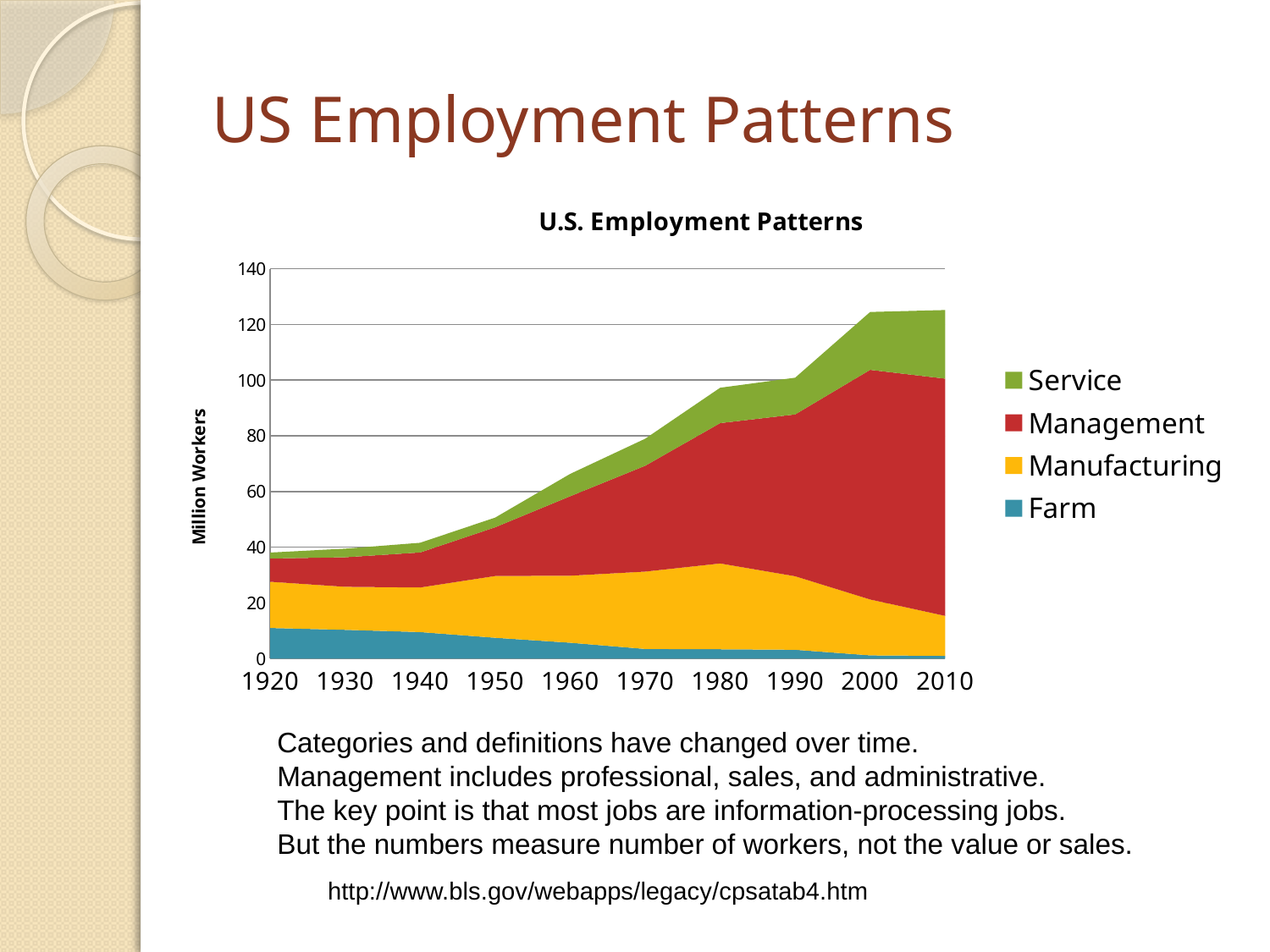
What is the title of the chart? U.S. Employment Patterns How many years are marked along the x axis? 10 How many series does the legend list? 4 Is the total number of workers in 1950 greater or less than 40? greater Is the total number of workers in 2010 greater or less than 120? greater Which is larger in 2010, the Management series or the Farm series? Management Does the total number of workers rise or fall from 1920 to 2010? Rise What is the label on the vertical axis? Million Workers What kind of chart is shown on the slide? Stacked area chart Is the total number of workers in 1960 greater or less than 60? greater Does the Farm series rise or fall from 1920 to 2010? Fall